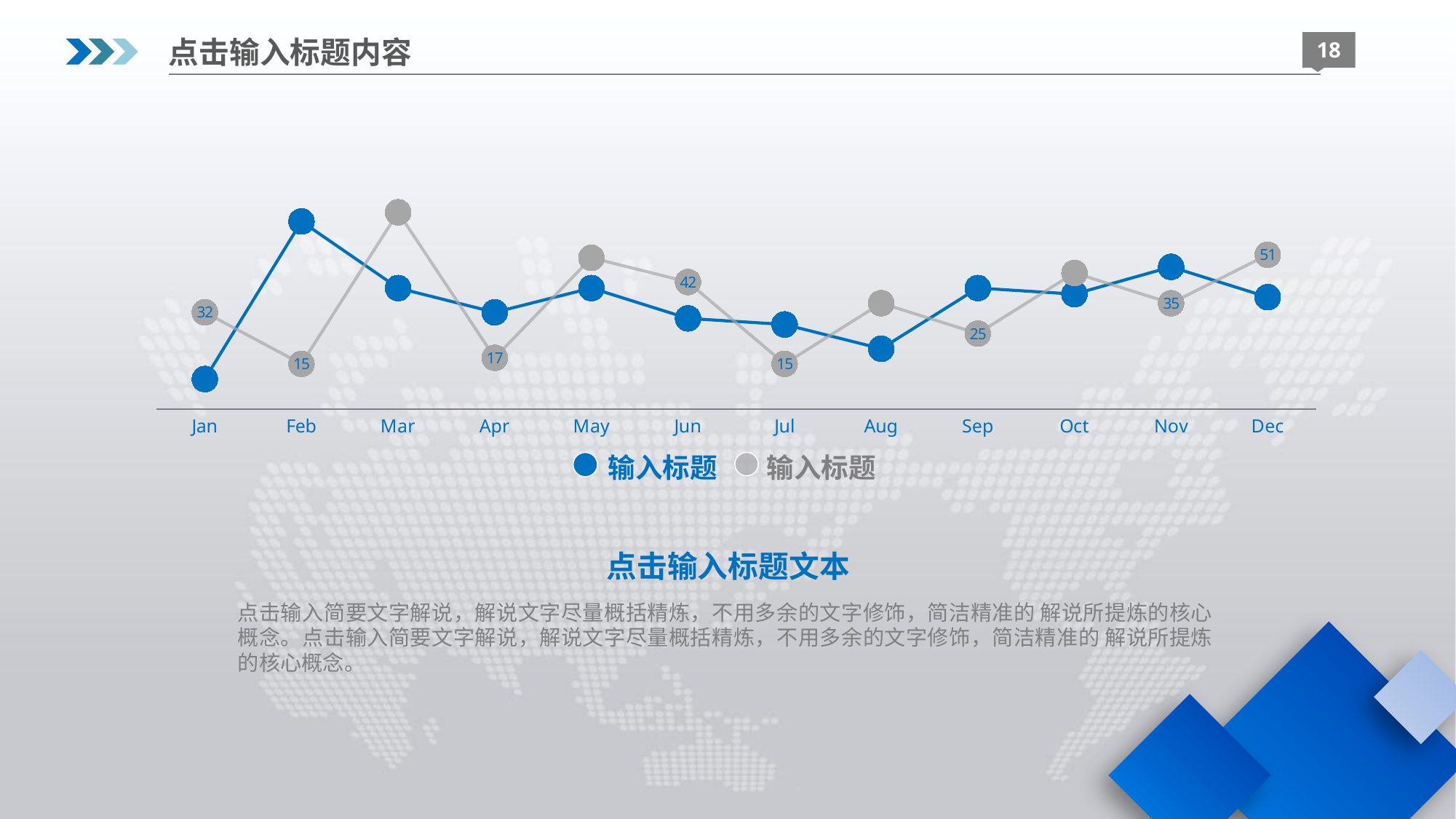
In which month does the blue series reach its highest point? Feb What is the value of the grey series in Jan? 32 What is the value of the grey series in Jun? 42 In which month is the blue series at its lowest point? Jan What type of chart is shown on the slide? line chart What is the difference between the grey series values in Dec and Nov? 16 In Jan, which series has the higher value, the blue or the grey? grey What is the value of the grey series in Dec? 51 How many months are plotted along the x axis? 12 How many series does the legend list? 2 What is the value of the grey series in Sep? 25 What is the difference between the grey series values in Jun and Jul? 27